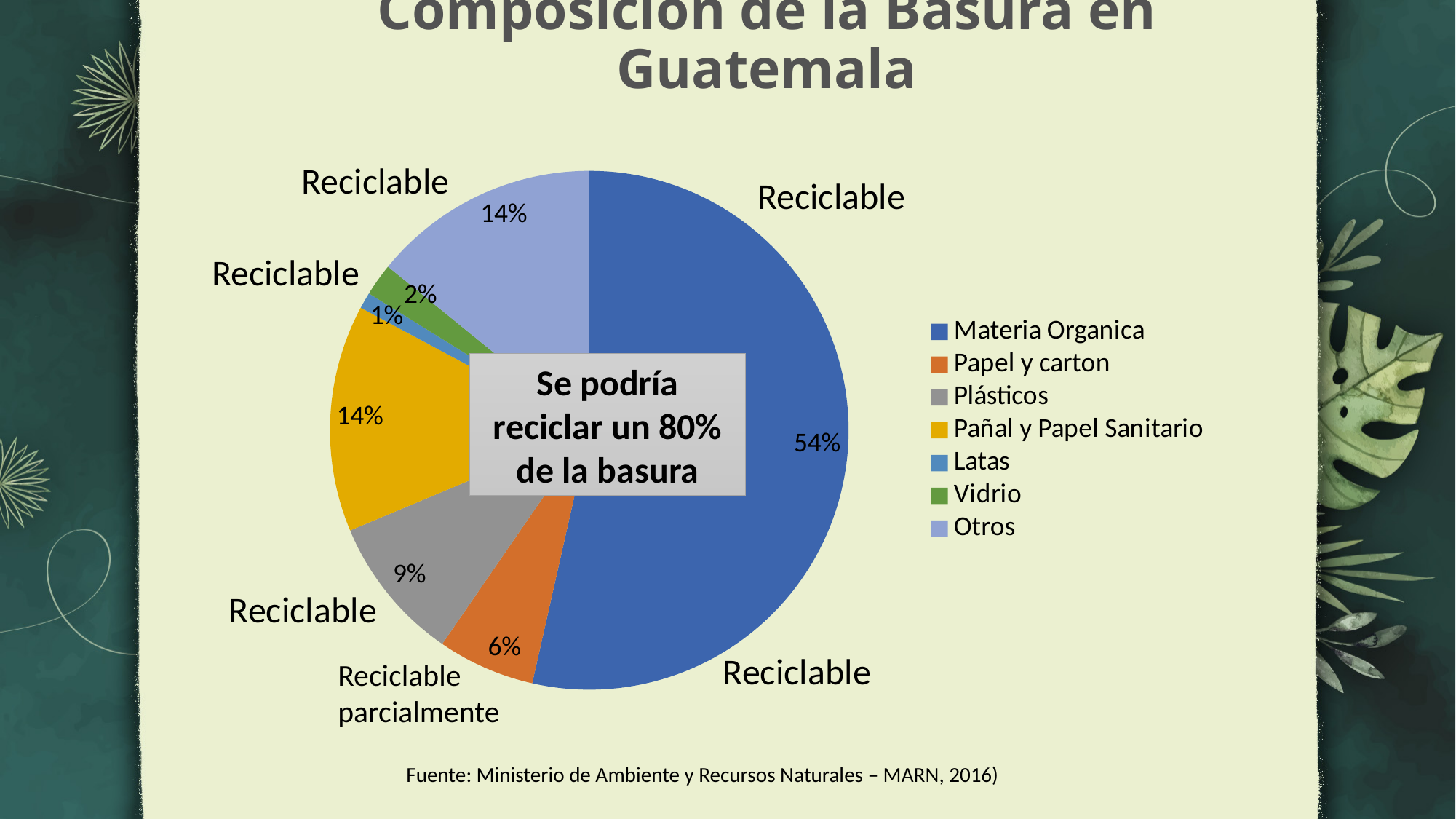
Which category has the largest share of the pie? Materia Organica What is the title of the chart? Composición de la Basura en Guatemala What is the difference in percentage points between Materia Organica and Pañal y Papel Sanitario? 40 What percentage of the waste is Vidrio? 2% What percentage of the waste is Latas? 1% What percentage of the waste is Materia Organica? 54% Which category has the smallest share of the pie? Latas What kind of chart is shown on the slide? pie chart What percentage of the waste is Papel y carton? 6% What percentage of the waste is Plásticos? 9% How many categories does the legend list? 7 Which is larger, the share for Plásticos or the share for Papel y carton? Plásticos